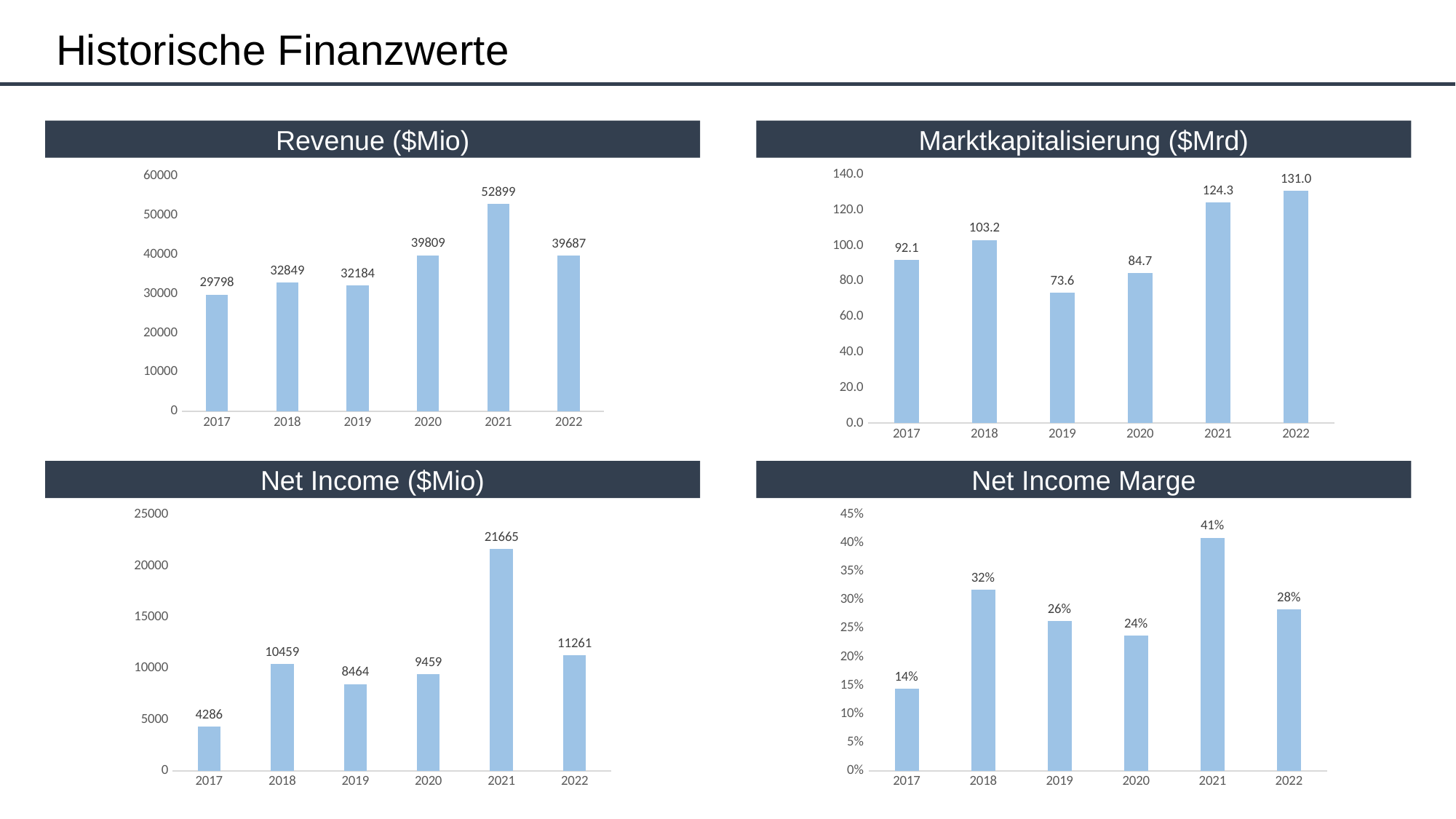
In the Marktkapitalisierung ($Mrd) chart, which year has the highest value? 2022 In the Net Income ($Mio) chart, what is the value for 2017? 4286 In the Net Income ($Mio) chart, what is the difference between the 2018 and 2019 values? 1995 In the Net Income Marge chart, which year has the highest margin? 2021 In the Net Income ($Mio) chart, how many years are shown on the x axis? 6 In the Revenue ($Mio) chart, what is the value for 2021? 52899 In the Marktkapitalisierung ($Mrd) chart, is the value for 2018 larger or smaller than the value for 2020? larger In the Revenue ($Mio) chart, which year has the lowest revenue? 2017 In the Marktkapitalisierung ($Mrd) chart, what is the value for 2019? 73.6 In the Net Income Marge chart, what is the value for 2020? 24% What kind of chart is the Net Income Marge chart? bar chart In the Revenue ($Mio) chart, what is the difference between the 2021 and 2022 values? 13212